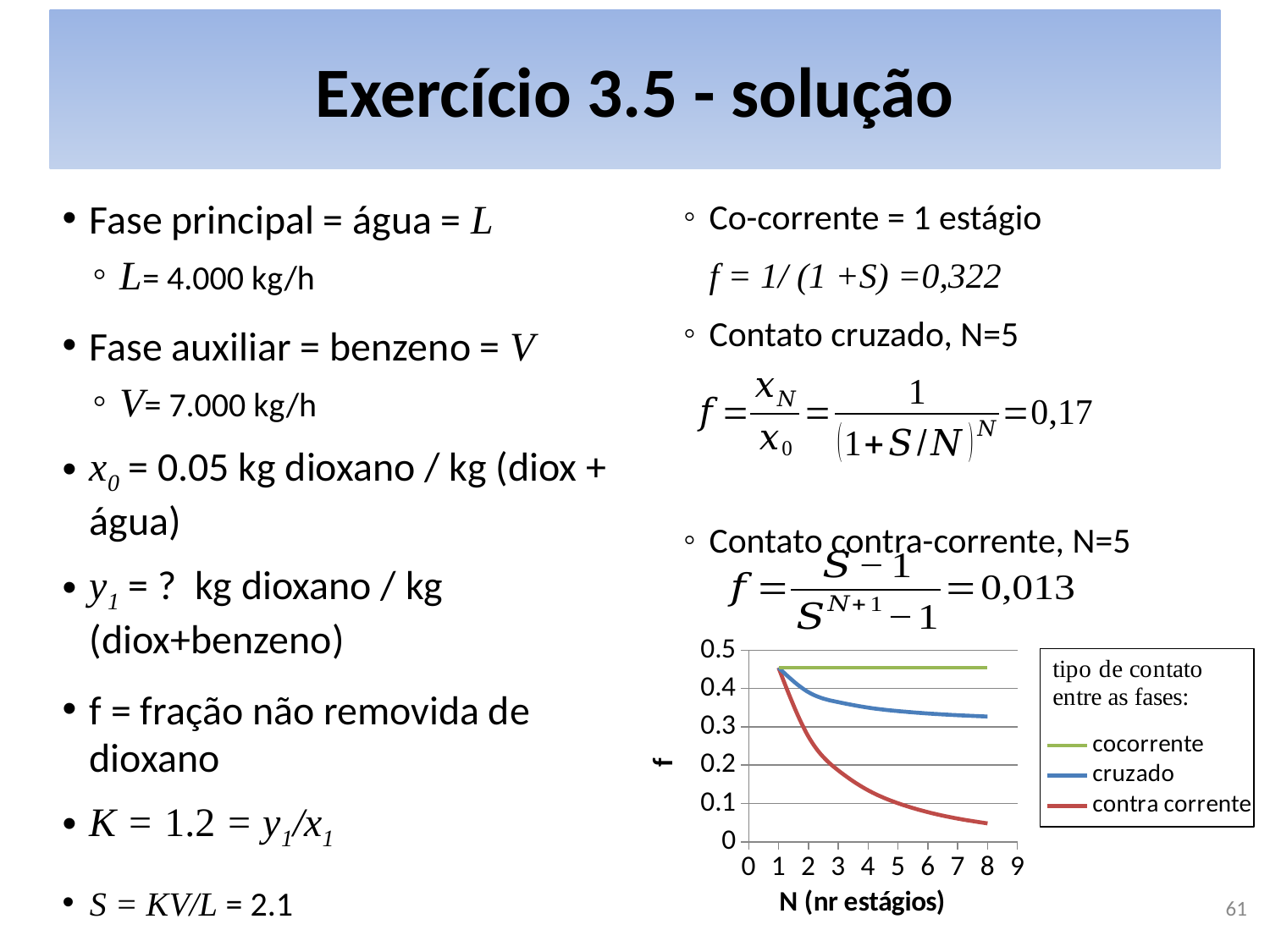
What kind of chart is shown on the slide? line chart Which series has the highest value of f at N=8? cocorrente Is the value of f for the contra corrente series at N=8 greater or less than 0.1? less What is the title of the x axis of the chart? N (nr estágios) Is the value of f for the cocorrente series at N=8 greater or less than 0.4? greater Does the value of f for the contra corrente series rise or fall as N increases? fall How many series does the chart legend list? 3 Which series has the lowest value of f at N=8? contra corrente Which series are listed in the chart legend? cocorrente, cruzado, contra corrente Is the value of f for the cruzado series at N=8 greater or less than 0.3? greater At N=8, which series has the larger value of f: cruzado or contra corrente? cruzado Does the value of f for the cruzado series rise or fall as N increases? fall